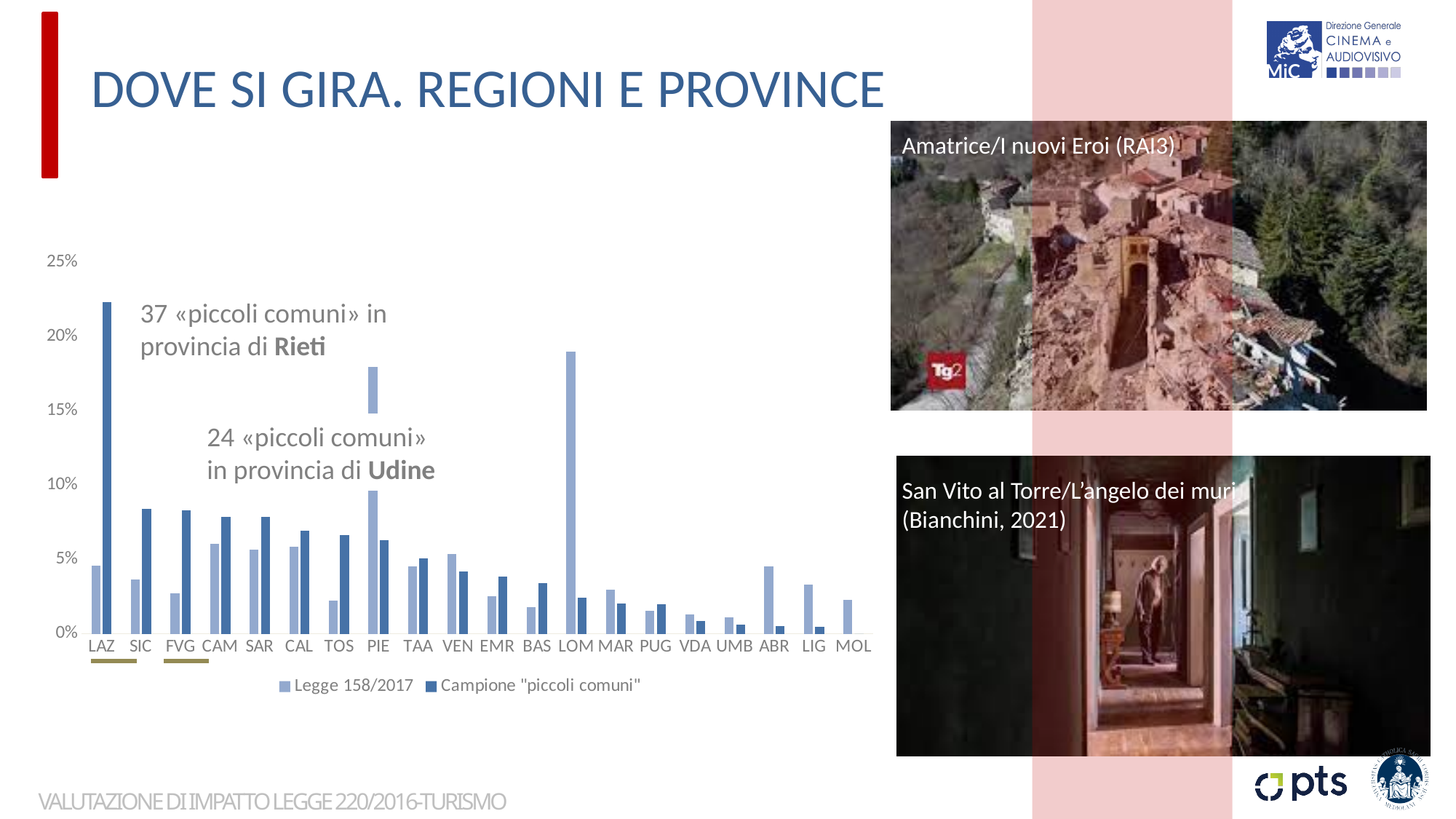
Is the "Campione "piccoli comuni"" value for SIC greater or less than 10%? less For LOM, which series has the larger value: "Legge 158/2017" or "Campione "piccoli comuni""? Legge 158/2017 Is the "Legge 158/2017" value for LOM greater or less than 15%? greater How many series does the chart legend list? 2 What kind of chart is shown on the slide? Bar chart Which region has the highest value for the "Campione "piccoli comuni"" series? LAZ What are the two series named in the chart legend? Legge 158/2017 and Campione "piccoli comuni" Is the "Campione "piccoli comuni"" value for LAZ greater or less than 20%? greater For LAZ, which series has the larger value: "Legge 158/2017" or "Campione "piccoli comuni""? Campione "piccoli comuni" How many regions are shown on the x axis of the chart? 20 Which region has the highest value for the "Legge 158/2017" series? LOM